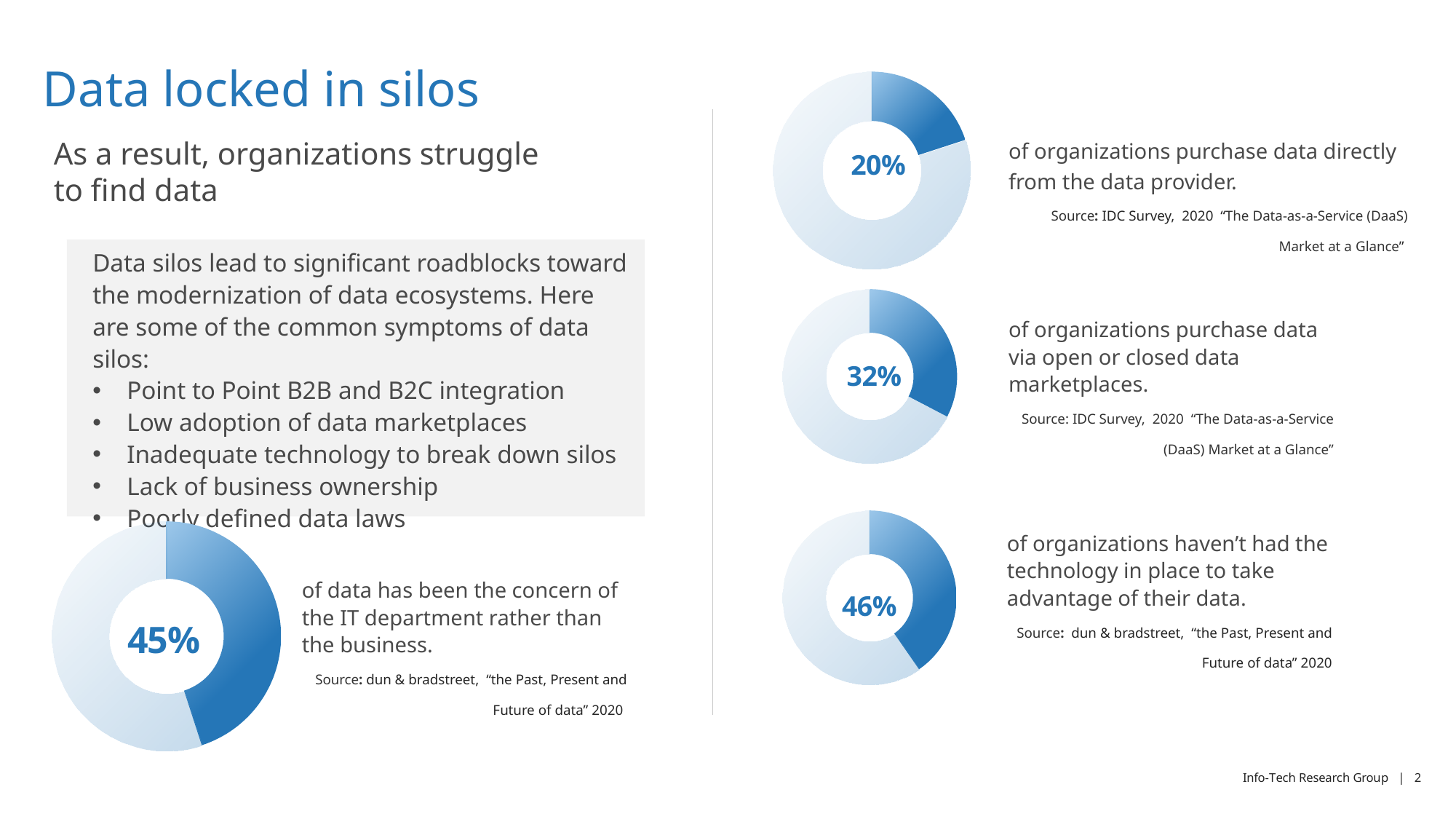
Which donut chart shows the lowest percentage: the one at the bottom left, top right, middle right, or bottom right? Top right (20%) What percentage is shown in the donut chart at the top right of the slide, next to the text about purchasing data directly from the data provider? 20% What percentage is shown in the bottom-right donut chart, next to the text about organizations that haven't had the technology in place? 46% Which is larger: the percentage in the bottom-left donut chart or the percentage in the middle-right donut chart? Bottom left (45%) How many donut charts are on the slide? 4 What is the difference between the percentage in the bottom-right donut chart and the percentage in the top-right donut chart? 26% What kind of chart is used to display the percentages on this slide? Donut (pie) chart What percentage is shown in the middle-right donut chart, next to the text about purchasing data via open or closed data marketplaces? 32% Which donut chart shows the highest percentage: the one at the bottom left, top right, middle right, or bottom right? Bottom right (46%) What is the title of the slide containing the donut charts? Data locked in silos What percentage is shown in the centre of the donut chart at the bottom left of the slide? 45% What is the difference between the percentage in the middle-right donut chart and the percentage in the top-right donut chart? 12%